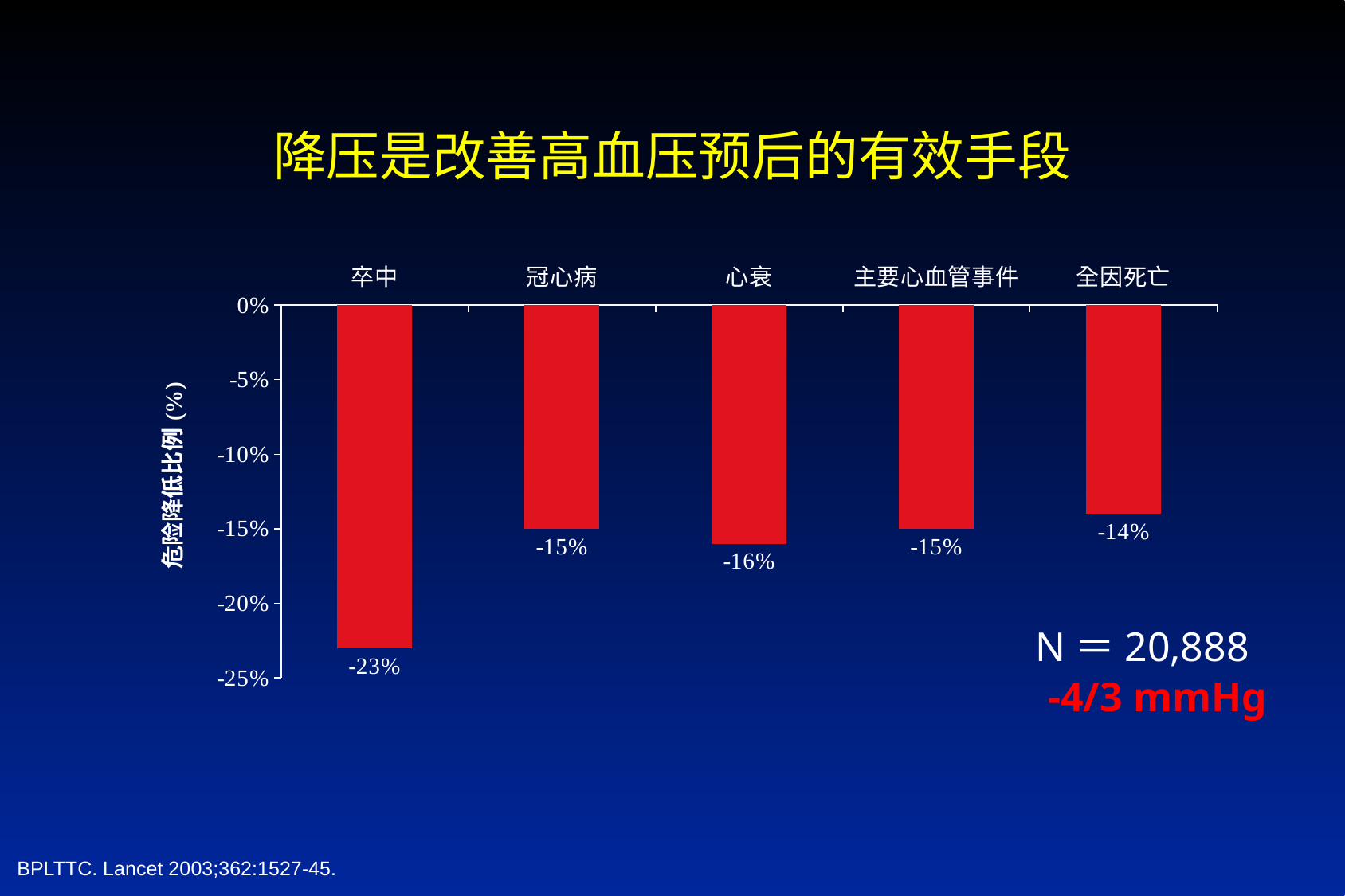
What is the value for 卒中? -23% Which category shows the smallest risk reduction (value closest to 0%)? 全因死亡 How many categories are shown in the chart? 5 Which category shows the largest risk reduction (most negative value)? 卒中 What kind of chart is shown on the slide? bar chart Is the value for 卒中 greater or less than -20%? less What is the value for 冠心病? -15% What is the y-axis label of the chart? 危险降低比例 (%) What is the value for 全因死亡? -14% What is the value for 心衰? -16% Which has a larger risk reduction, 心衰 or 主要心血管事件? 心衰 What is the difference between the values for 卒中 and 全因死亡? 9 percentage points